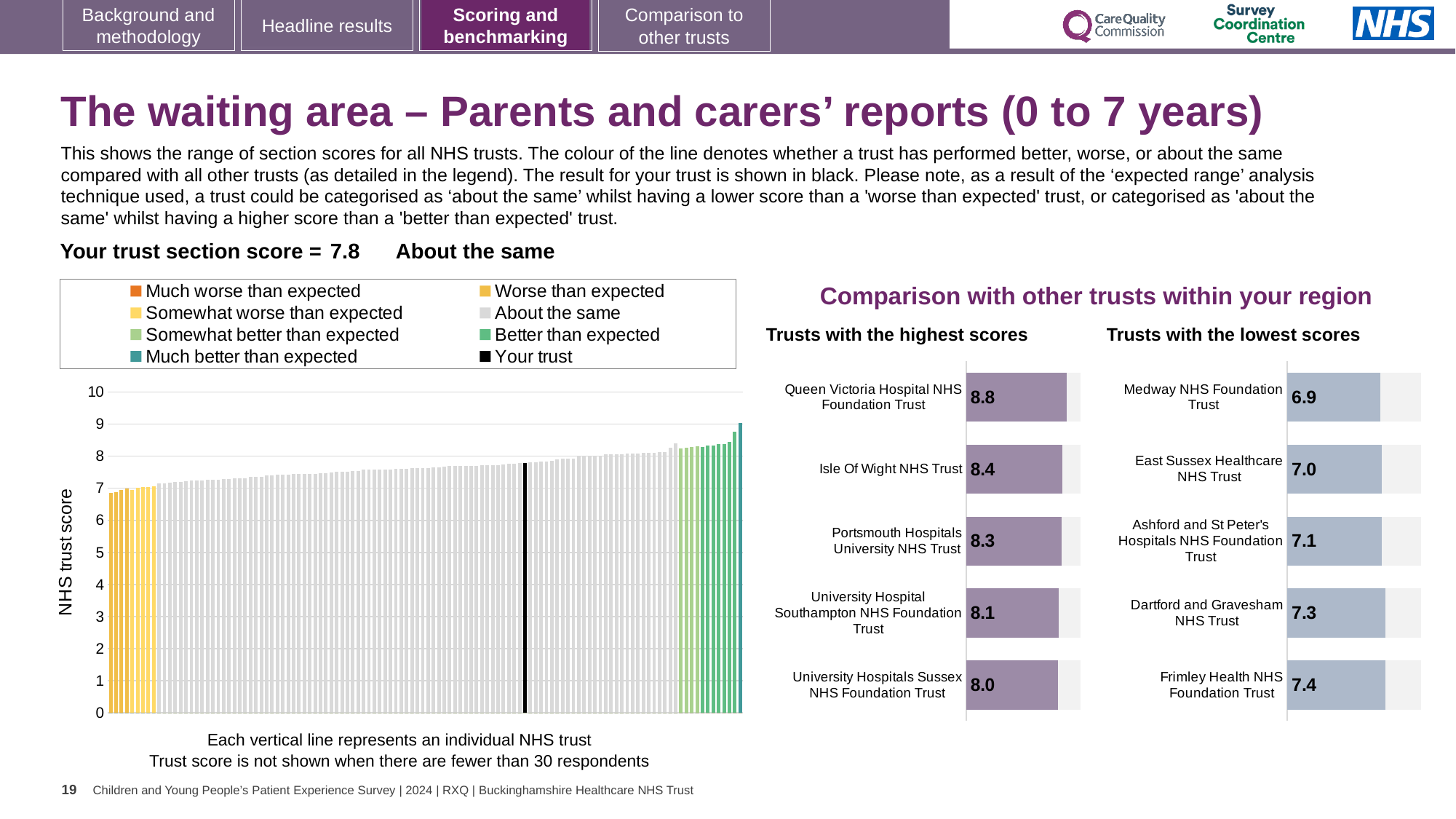
In the large chart on the left showing all NHS trusts, is the value for the black bar (your trust) greater or less than 7? greater In the 'Trusts with the highest scores' chart, what is the score for Queen Victoria Hospital NHS Foundation Trust? 8.8 How many trusts are shown in the 'Trusts with the highest scores' chart? 5 In the 'Trusts with the lowest scores' chart, what is the score for Medway NHS Foundation Trust? 6.9 In the 'Trusts with the lowest scores' chart, what is the score for Dartford and Gravesham NHS Trust? 7.3 In the 'Trusts with the highest scores' chart, what is the difference between the scores of Queen Victoria Hospital NHS Foundation Trust and University Hospitals Sussex NHS Foundation Trust? 0.8 In the 'Trusts with the highest scores' chart, which trust has the lowest score? University Hospitals Sussex NHS Foundation Trust In the 'Trusts with the highest scores' chart, what is the score for Portsmouth Hospitals University NHS Trust? 8.3 In the 'Trusts with the lowest scores' chart, which has the larger score: East Sussex Healthcare NHS Trust or Ashford and St Peter's Hospitals NHS Foundation Trust? Ashford and St Peter's Hospitals NHS Foundation Trust How many entries does the legend of the large chart on the left list? 8 In the 'Trusts with the lowest scores' chart, what is the difference between the scores of Frimley Health NHS Foundation Trust and Medway NHS Foundation Trust? 0.5 In the 'Trusts with the lowest scores' chart, which trust has the highest score? Frimley Health NHS Foundation Trust